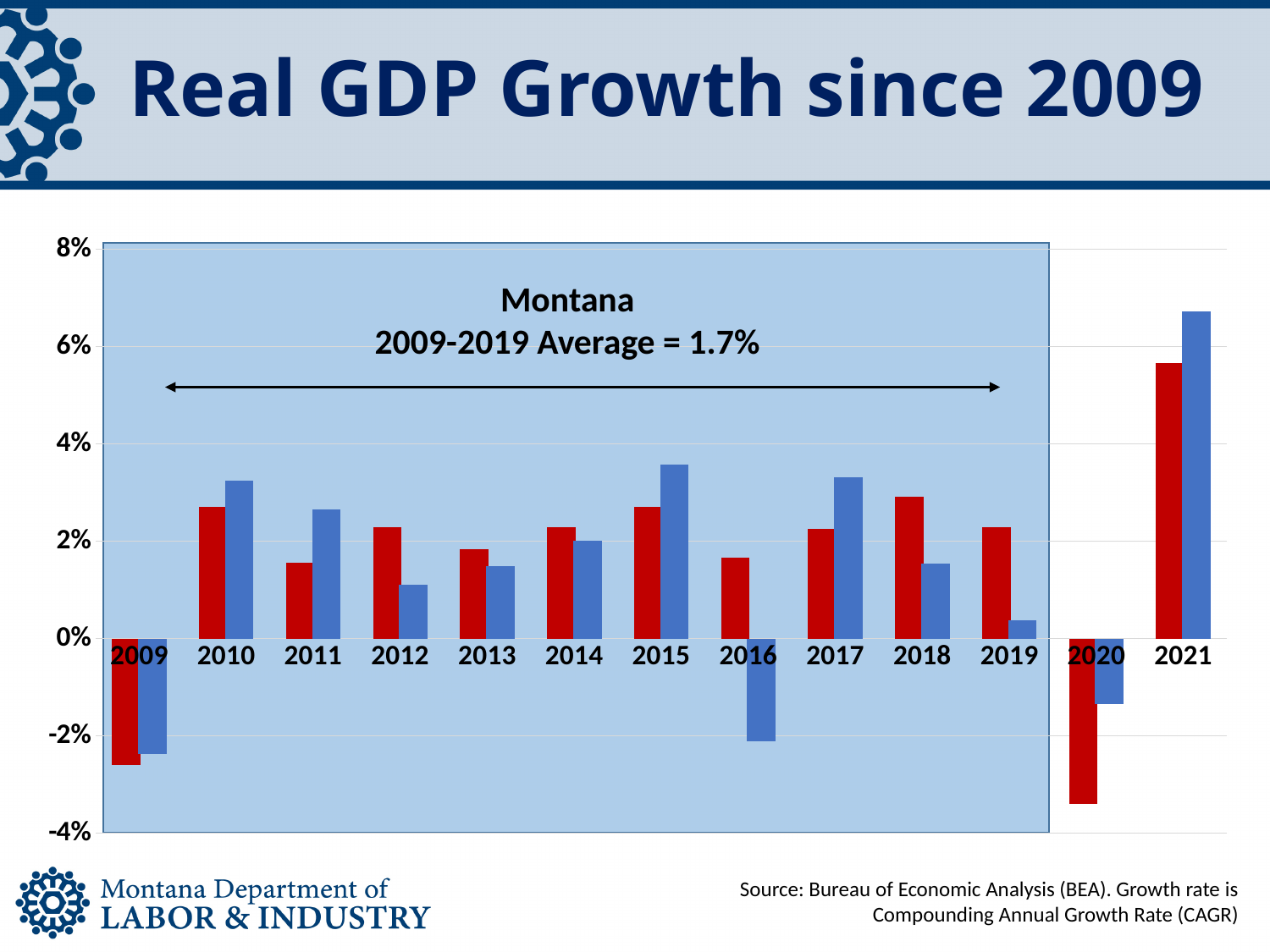
According to the annotation on the chart, what was Montana's 2009-2019 average growth? 1.7% In which year is the blue bar the highest? 2021 What kind of chart is shown on the slide? bar chart Is the value of the blue bar for 2021 greater or less than 6%? greater In 2021, which bar is larger, the red bar or the blue bar? blue In 2016, which bar is larger, the red bar or the blue bar? red In which year is the red bar the lowest? 2020 In which year is the red bar the highest? 2021 Is the value of the red bar for 2021 greater or less than 4%? greater What is the title of the slide's chart? Real GDP Growth since 2009 How many years are shown on the x axis of the chart? 13 Is the value of the red bar for 2020 greater or less than -2%? less